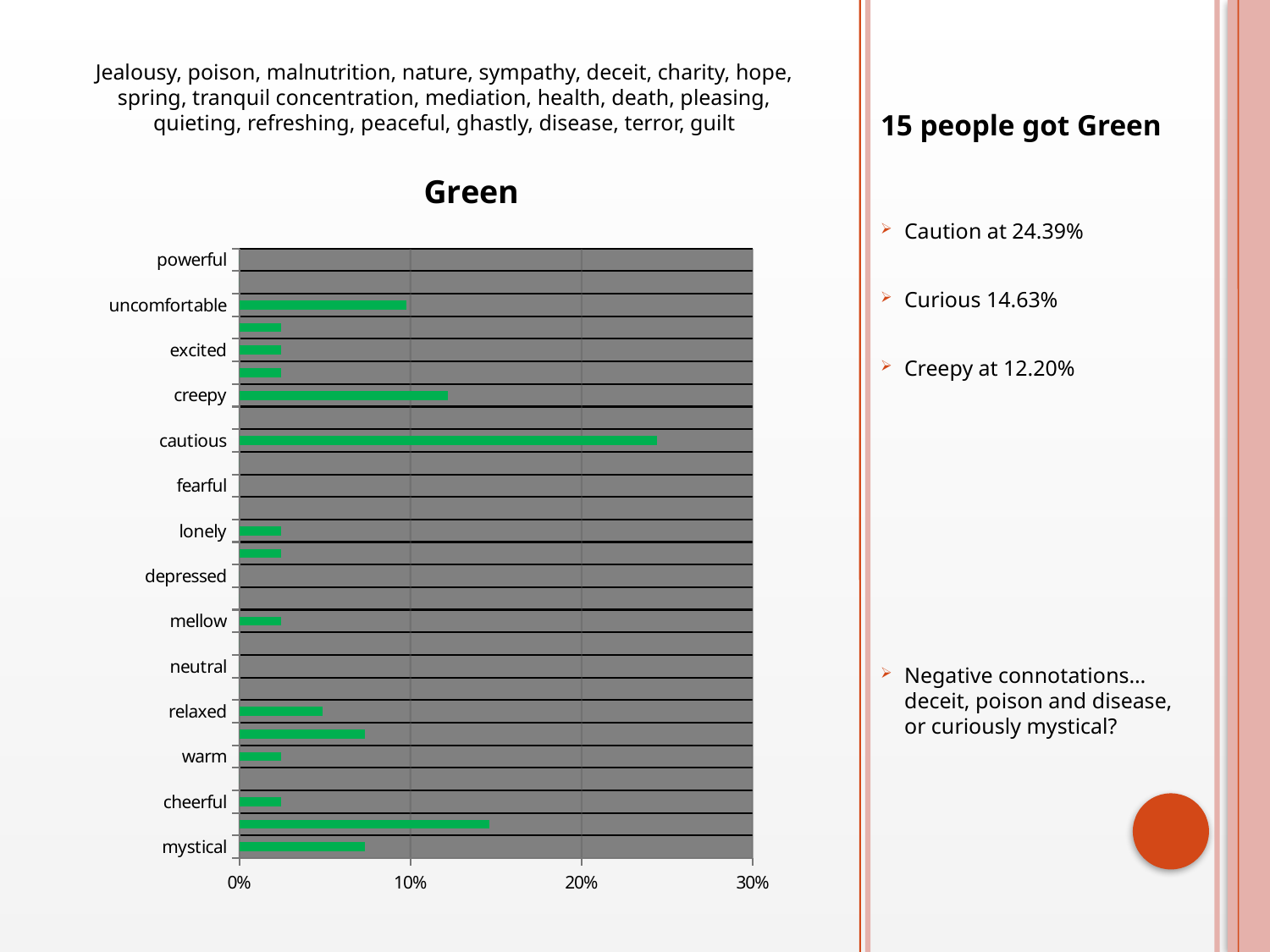
Is the value for creepy greater or less than 10%? greater Is the value for mellow greater or less than 10%? less Which labelled category has the longest bar in the chart? cautious Is the value for mystical greater or less than 10%? less Which is larger, the value for mystical or the value for warm? mystical What is the title of the chart? Green What is the highest value shown on the horizontal axis of the chart? 30% Which is larger, the value for creepy or the value for relaxed? creepy Which is larger, the value for cautious or the value for creepy? cautious What kind of chart is shown on the slide? bar chart